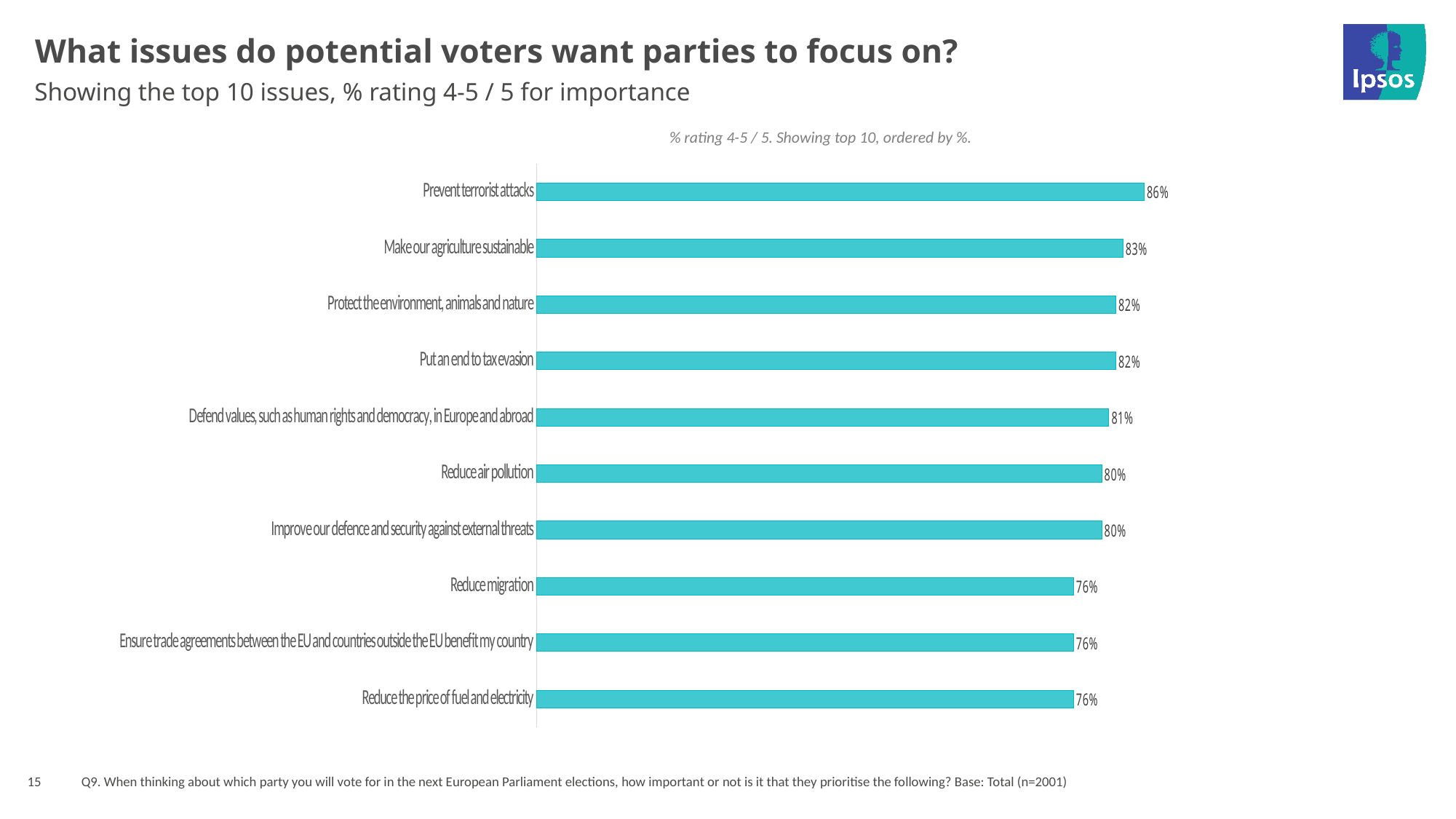
What is the note shown above the chart? % rating 4-5 / 5. Showing top 10, ordered by %. What is the difference in percentage points between 'Prevent terrorist attacks' and 'Reduce the price of fuel and electricity'? 10 percentage points What type of chart is used on this slide? Bar chart What is the value shown for 'Reduce migration'? 76% How many issues share the lowest value of 76%? 3 Which has a higher value: 'Put an end to tax evasion' or 'Improve our defence and security against external threats'? Put an end to tax evasion What is the difference between 'Make our agriculture sustainable' and 'Reduce air pollution'? 3 percentage points What is the value shown for 'Defend values, such as human rights and democracy, in Europe and abroad'? 81% What is the value shown for 'Make our agriculture sustainable'? 83% How many issues are shown in the chart? 10 What percentage of potential voters rated 'Prevent terrorist attacks' as important (4-5 / 5)? 86% Which issue has the highest percentage rating it as important? Prevent terrorist attacks